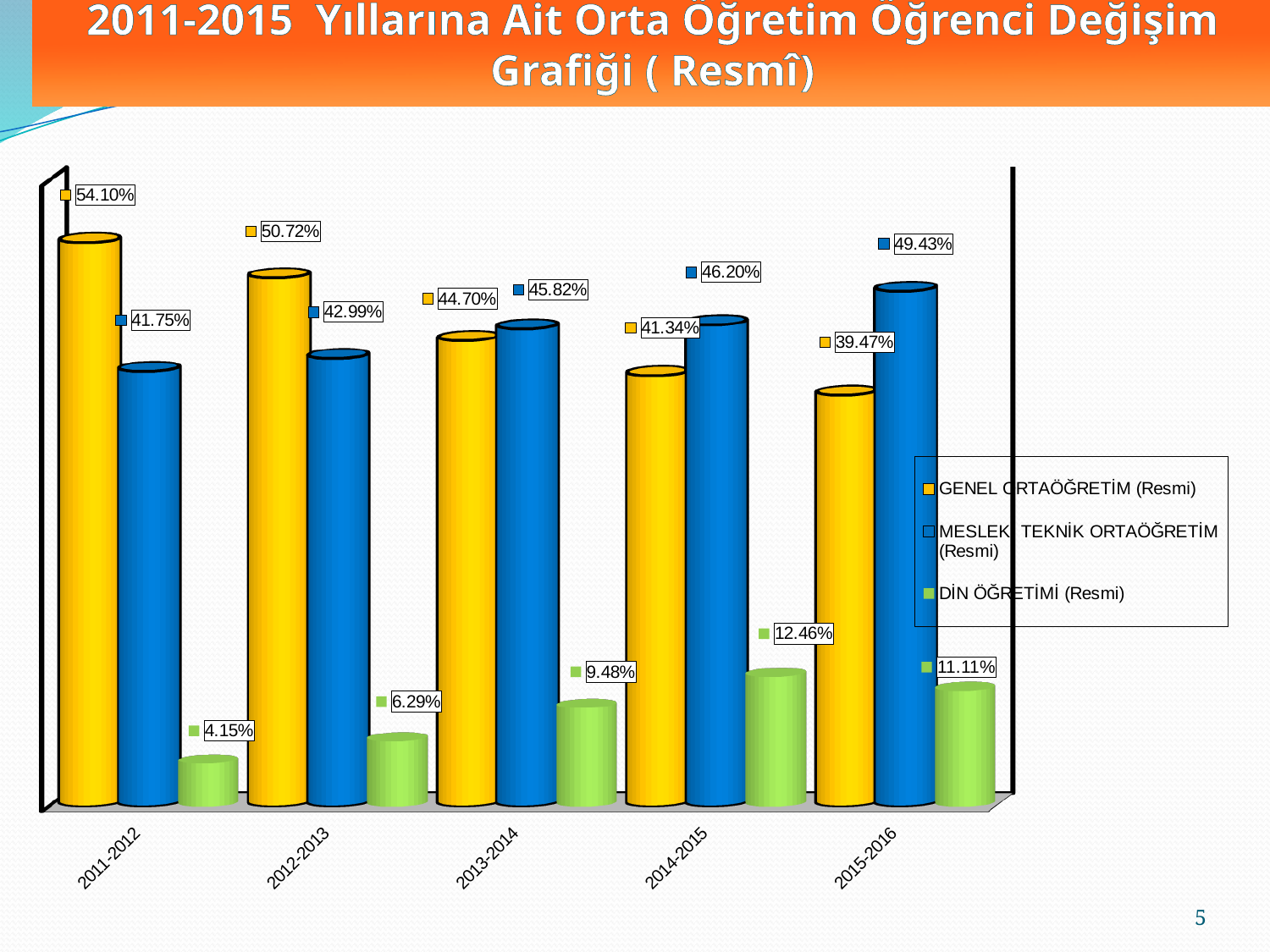
In which school year is the DİN ÖĞRETİMİ (Resmi) value highest? 2014-2015 In which school year is the GENEL ORTAÖĞRETİM (Resmi) value lowest? 2015-2016 In 2014-2015, which is larger: GENEL ORTAÖĞRETİM (Resmi) or MESLEKİ TEKNİK ORTAÖĞRETİM (Resmi)? MESLEKİ TEKNİK ORTAÖĞRETİM (Resmi) How many series does the legend list? 3 What is the value for DİN ÖĞRETİMİ (Resmi) in 2014-2015? 12.46% Does the GENEL ORTAÖĞRETİM (Resmi) value rise or fall from 2011-2012 to 2015-2016? Fall What is the difference between the GENEL ORTAÖĞRETİM (Resmi) value and the MESLEKİ TEKNİK ORTAÖĞRETİM (Resmi) value in 2011-2012? 12.35% What colour represents DİN ÖĞRETİMİ (Resmi) in the chart? Green What type of chart is shown on the slide? Bar chart What is the value for GENEL ORTAÖĞRETİM (Resmi) in 2011-2012? 54.10% How many school-year categories are shown on the x axis? 5 What is the value for MESLEKİ TEKNİK ORTAÖĞRETİM (Resmi) in 2015-2016? 49.43%